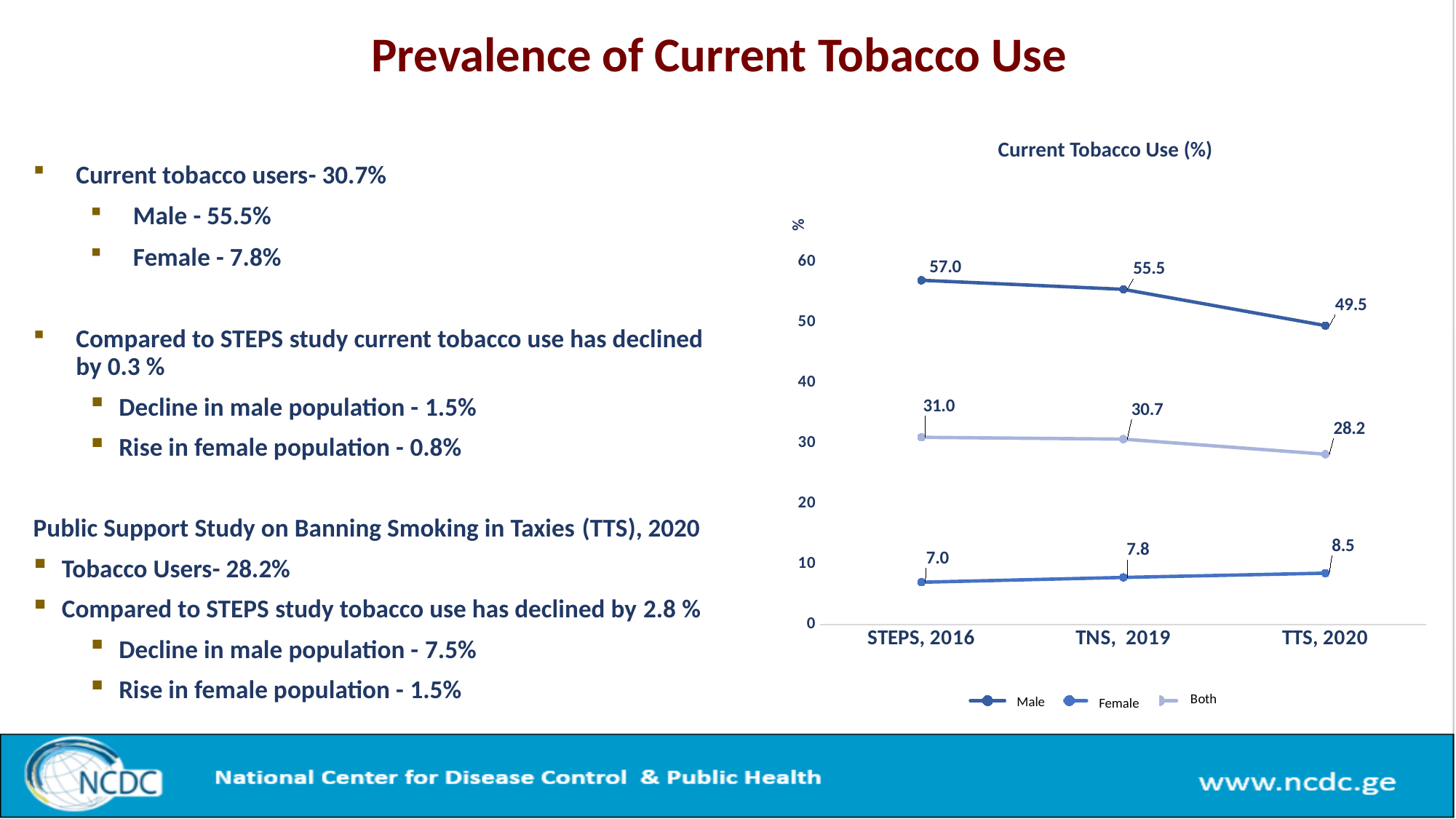
What is the Both value for TNS, 2019 in the Current Tobacco Use (%) chart? 30.7 What kind of chart is the Current Tobacco Use (%) chart? line chart In which survey is the Female value highest in the Current Tobacco Use (%) chart? TTS, 2020 What is the difference between the Male values for STEPS, 2016 and TTS, 2020 in the Current Tobacco Use (%) chart? 7.5 What is the difference between the Both values for STEPS, 2016 and TNS, 2019 in the Current Tobacco Use (%) chart? 0.3 How many surveys are shown on the x axis of the Current Tobacco Use (%) chart? 3 Which is larger in the Current Tobacco Use (%) chart: the Male value for TNS, 2019 or the Male value for TTS, 2020? TNS, 2019 How many series does the legend of the Current Tobacco Use (%) chart list? 3 What is the Female value for TTS, 2020 in the Current Tobacco Use (%) chart? 8.5 Does the Female series rise or fall from STEPS, 2016 to TTS, 2020 in the Current Tobacco Use (%) chart? rise What is the Male value for STEPS, 2016 in the Current Tobacco Use (%) chart? 57.0 In which survey is the Male value lowest in the Current Tobacco Use (%) chart? TTS, 2020